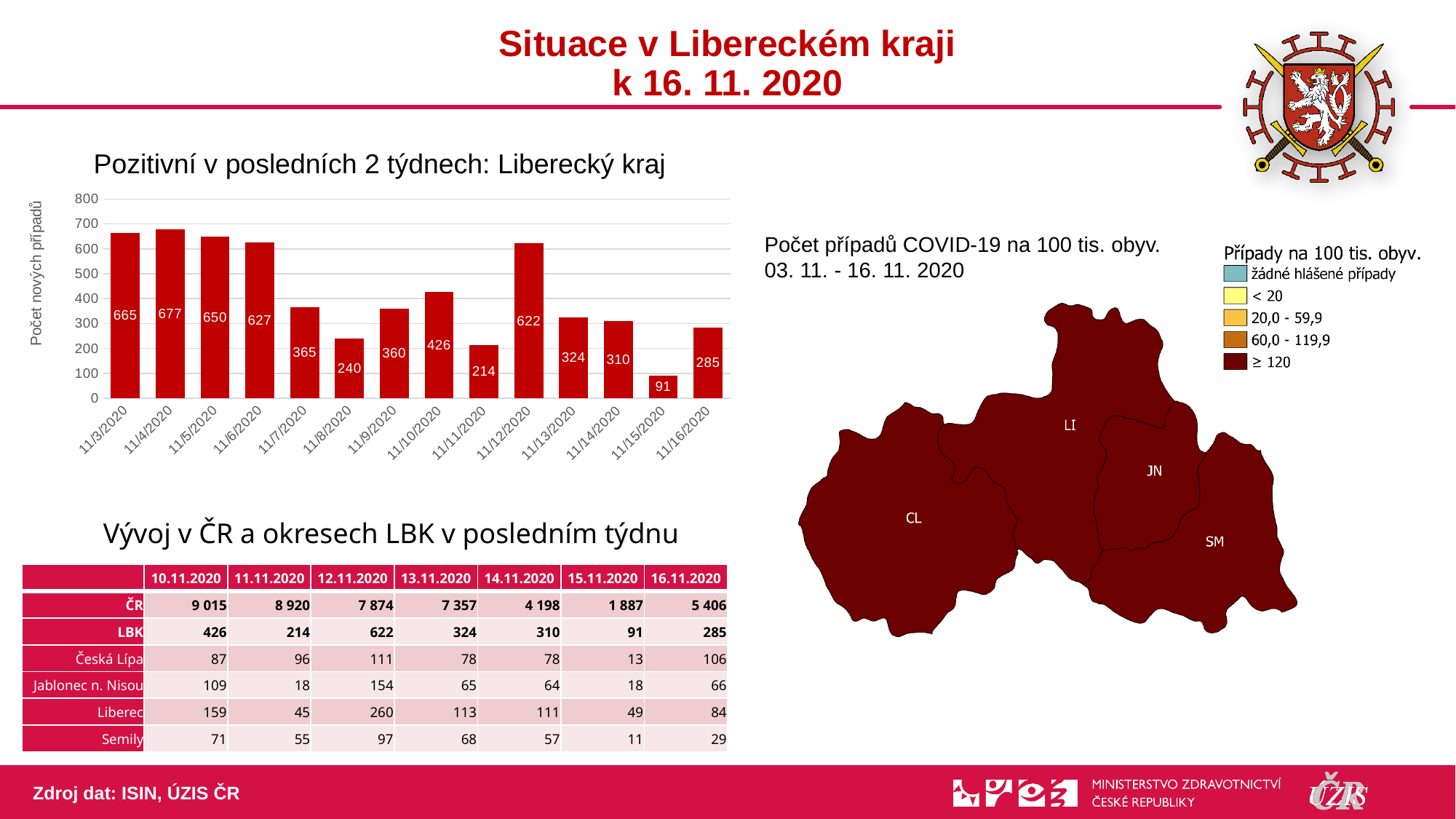
What type of chart is shown under the title "Pozitivní v posledních 2 týdnech: Liberecký kraj"? bar chart Which date has the lowest value in the bar chart? 11/15/2020 In the bar chart, what is the difference between the values for 11/3/2020 and 11/16/2020? 380 In the bar chart, what is the value for 11/15/2020? 91 Which date has the highest value in the bar chart? 11/4/2020 How many dates (bars) are shown in the bar chart? 14 In the bar chart, what is the value for 11/4/2020? 677 In the bar chart, which is larger: the value for 11/7/2020 or the value for 11/9/2020? 11/7/2020 Overall, do the values in the bar chart rise or fall from 11/3/2020 to 11/16/2020? fall In the bar chart, what is the difference between the values for 11/12/2020 and 11/11/2020? 408 In the bar chart, what is the value for 11/12/2020? 622 What is the label on the vertical axis of the bar chart? Počet nových případů